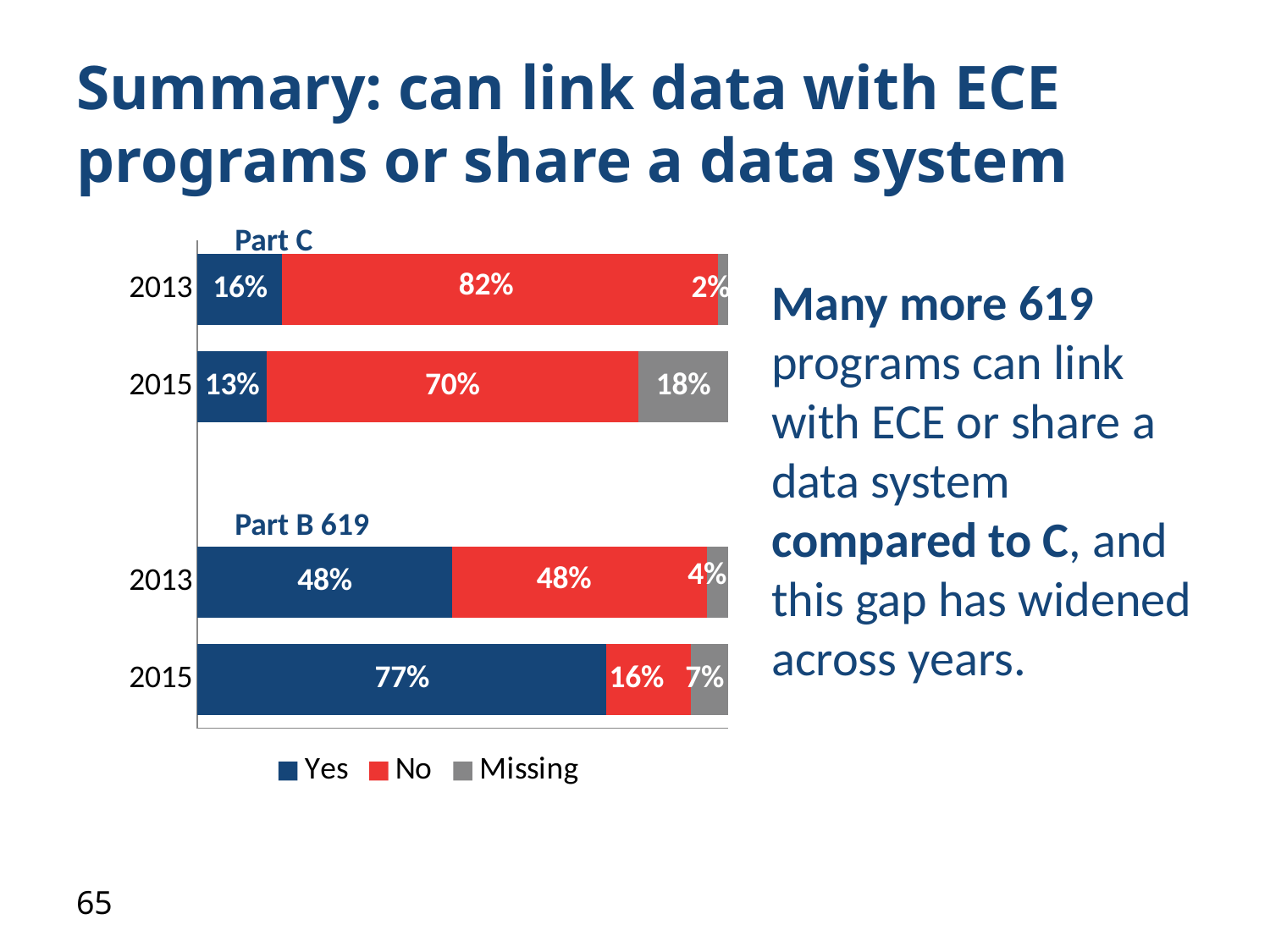
What kind of chart is shown on the slide? Stacked bar chart How many series does the legend list? 3 Did the Yes percentage for Part B 619 rise or fall from 2013 to 2015? Rise What is the difference between the Yes percentage for Part B 619 in 2015 and in 2013? 29% Which bar has the lowest Yes percentage? Part C, 2015 What percentage of Part B 619 programs answered Yes in 2015? 77% What is the Missing percentage for Part C in 2015? 18% What colour represents the Missing series in the chart? Grey Which is larger: the No percentage for Part C in 2013 or for Part C in 2015? Part C in 2013 What percentage of Part C programs answered Yes in 2013? 16% Which bar has the highest Yes percentage? Part B 619, 2015 What is the No percentage for Part B 619 in 2013? 48%